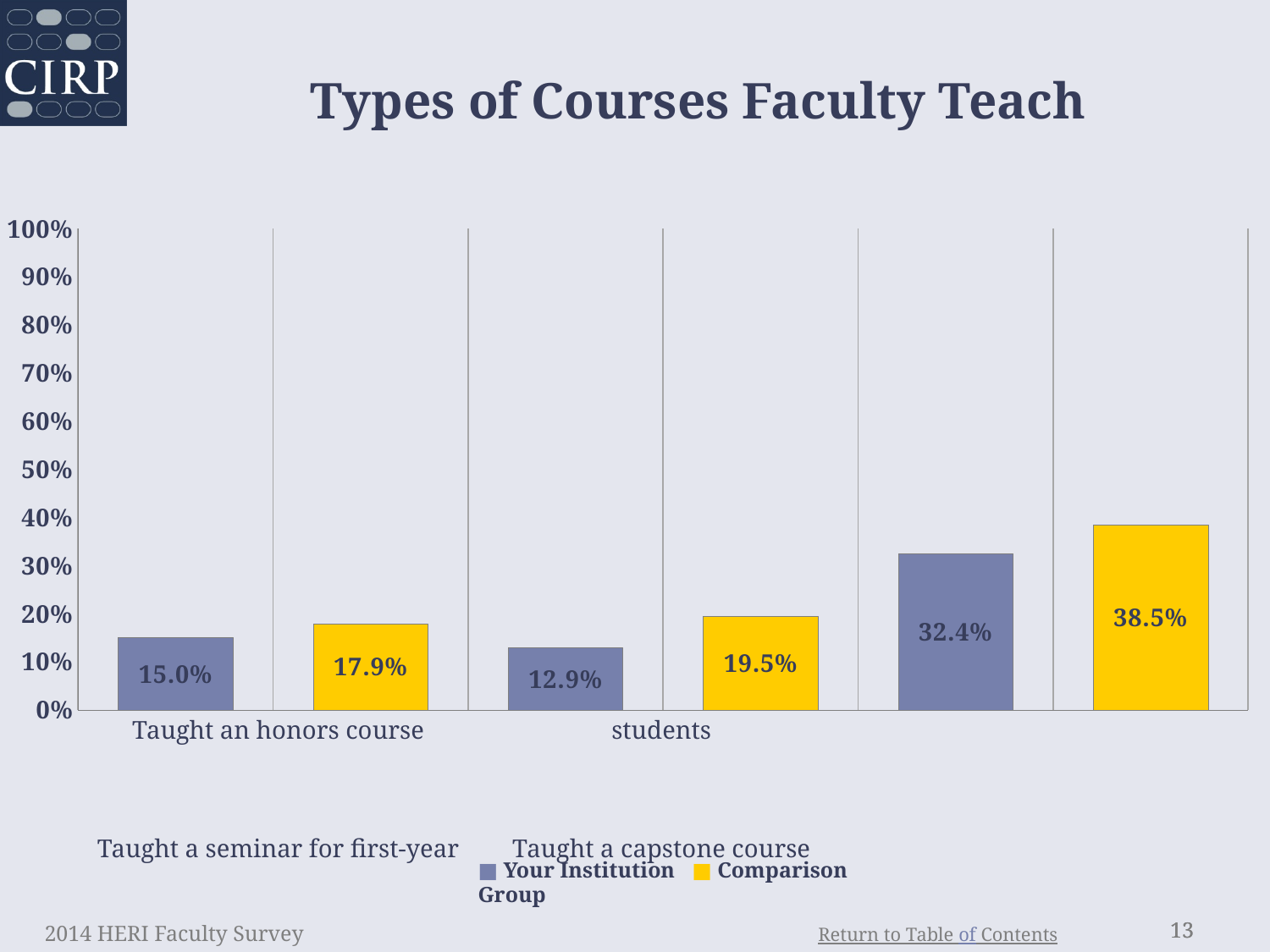
Which category has the highest value for Your Institution? Taught a capstone course How many series does the legend list? 2 For "Taught a seminar for first-year students", which is larger: Your Institution or the Comparison Group? Comparison Group Is the Comparison Group value for "Taught a capstone course" greater or less than 30%? greater Which category has the lowest value for the Comparison Group? Taught an honors course What is the value for the Comparison Group for "Taught an honors course"? 17.9% What is the value for the Comparison Group for "Taught a capstone course"? 38.5% What is the value for Your Institution for "Taught an honors course"? 15.0% What is the value for Your Institution for "Taught a seminar for first-year students"? 12.9% What type of chart is shown on the slide? Bar chart How many categories are shown on the x axis? 3 What is the difference between the Comparison Group and Your Institution values for "Taught a capstone course"? 6.1%